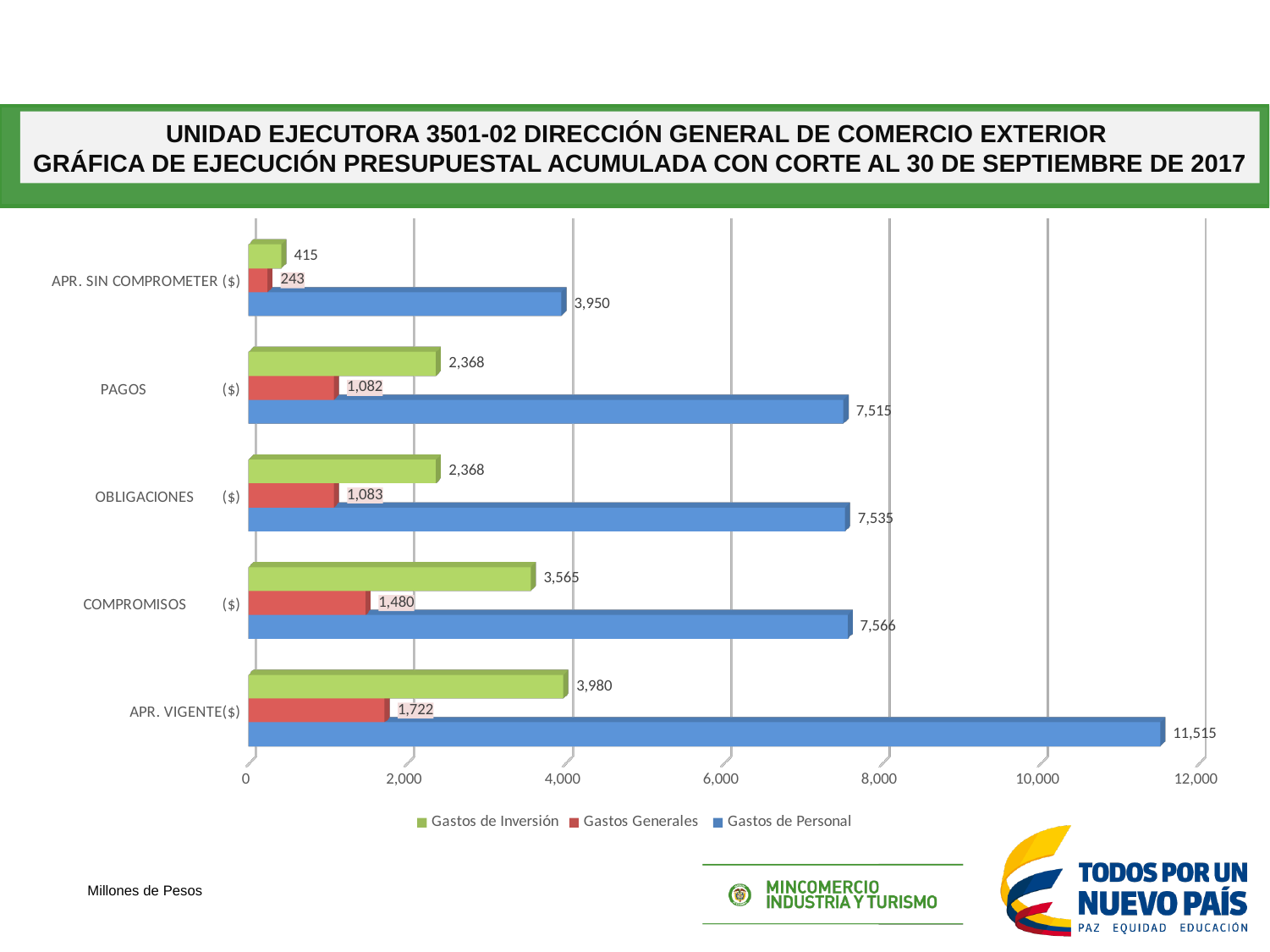
Which category has the highest value for Gastos de Personal? APR. VIGENTE($) Which category has the lowest value for Gastos de Inversión? APR. SIN COMPROMETER ($) What is the value of Gastos de Inversión for PAGOS ($)? 2,368 How many categories are shown on the y axis? 5 What is the value of Gastos Generales for APR. SIN COMPROMETER ($)? 243 Which is larger: Gastos de Inversión for COMPROMISOS ($) or Gastos de Inversión for OBLIGACIONES ($)? COMPROMISOS ($) What kind of chart is shown on the slide? Bar chart Which colour represents Gastos de Personal in the legend? Blue What is the value of Gastos de Personal for APR. VIGENTE($)? 11,515 What is the value of Gastos Generales for COMPROMISOS ($)? 1,480 How many series does the legend list? 3 What is the difference between Gastos de Personal for APR. VIGENTE($) and for COMPROMISOS ($)? 3,949